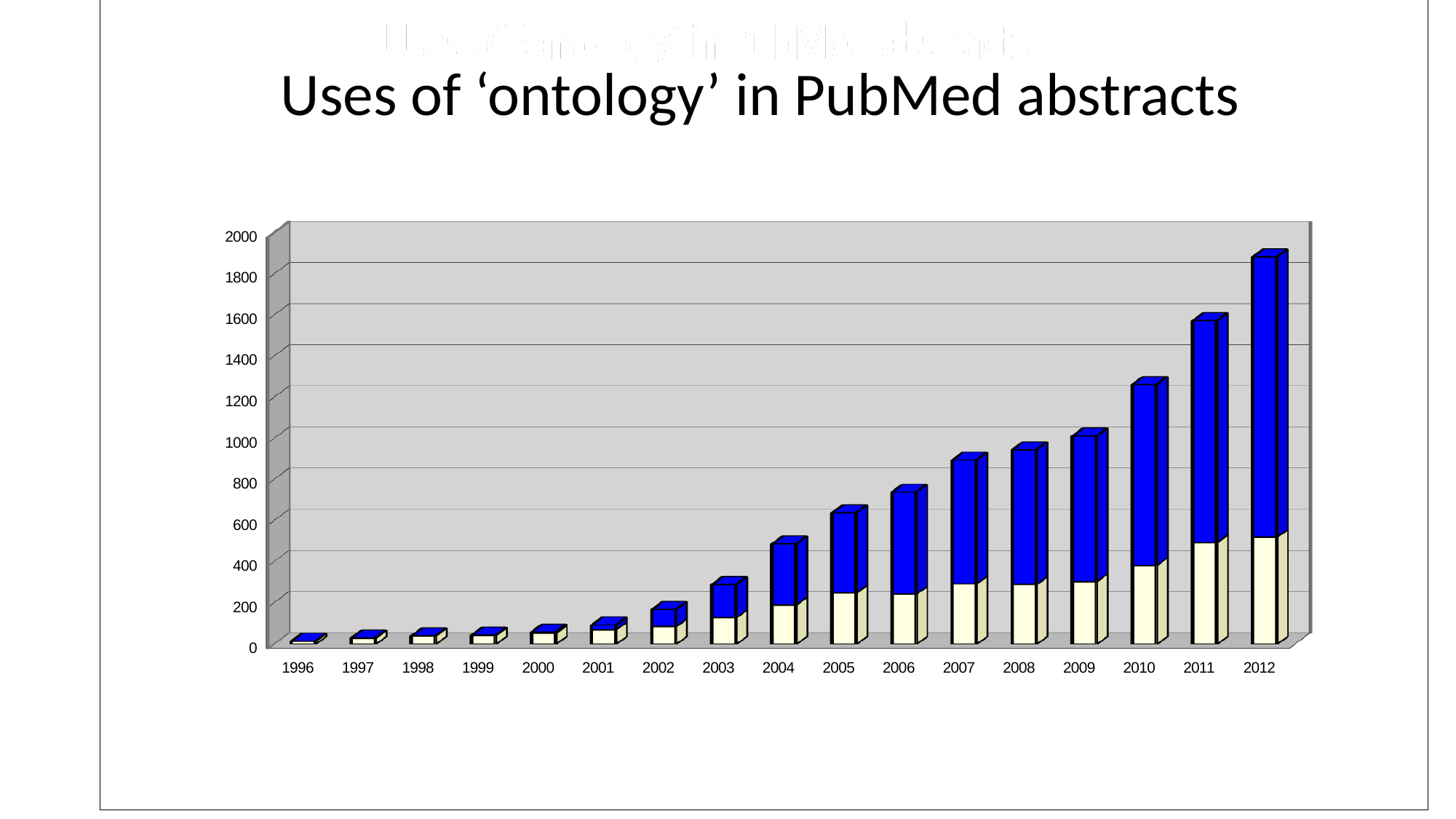
Is the total value for 2009 greater or less than 1200? less What kind of chart is shown on the slide? Bar chart Which year has the highest total bar? 2012 Is the total value for 2003 greater or less than 400? less Is the total value for 2005 greater or less than 400? greater Which year has the larger total bar, 2011 or 2008? 2011 Do the bar totals generally rise or fall from 1996 to 2012? Rise How many years are shown along the x axis of the chart? 17 Which year has the lowest total bar? 1996 What is the title of the chart on the slide? Uses of 'ontology' in PubMed abstracts